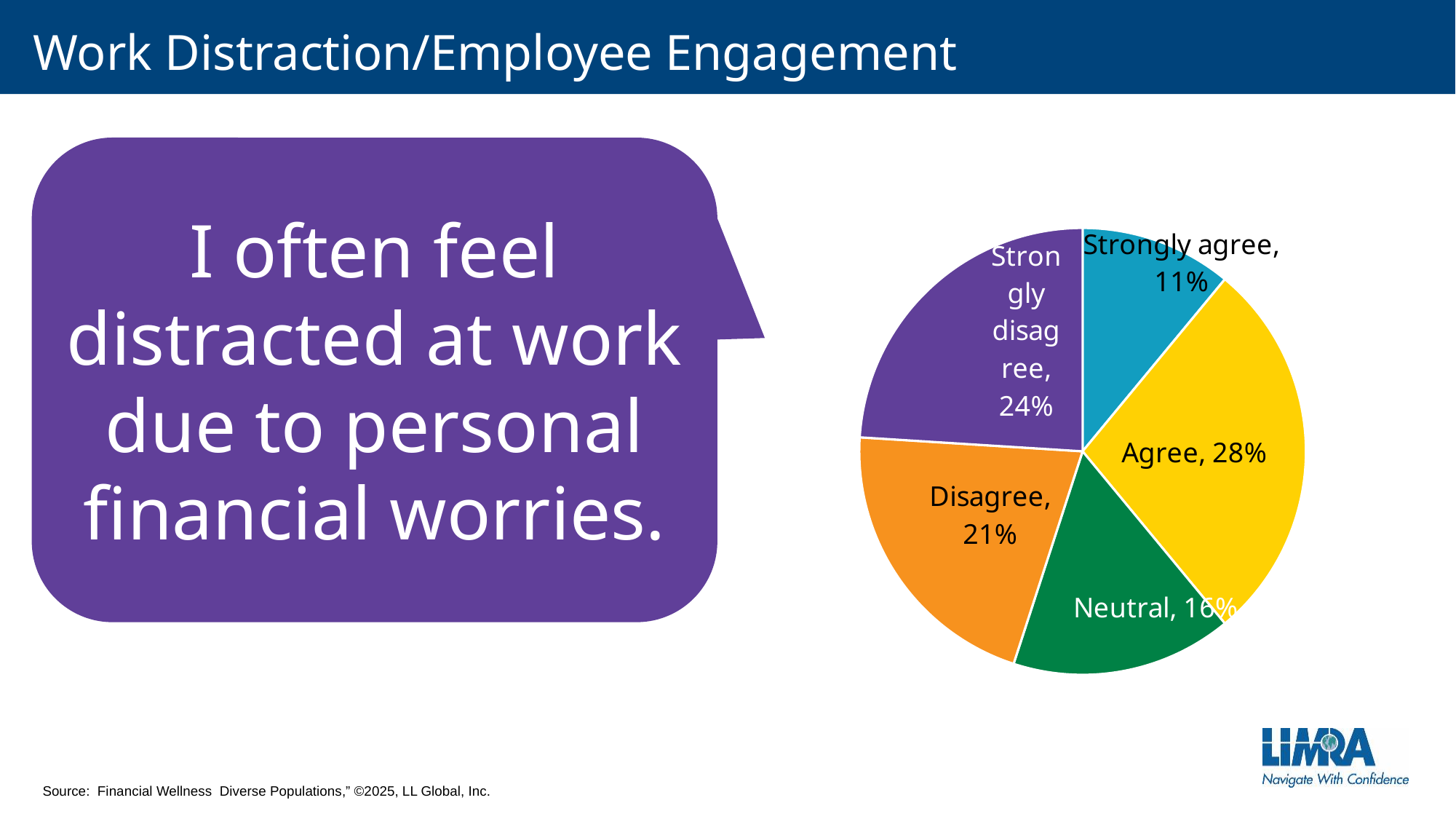
What colour is the "Agree" slice? Yellow Which response has the largest share of the pie? Agree What is the difference in percentage points between "Agree" and "Strongly agree"? 17 What percentage of respondents answered "Neutral"? 16% What percentage of respondents answered "Strongly disagree"? 24% Which response has the smallest share of the pie? Strongly agree What percentage of respondents answered "Strongly agree"? 11% Which is larger, the share for "Disagree" or the share for "Neutral"? Disagree What kind of chart is shown on the slide? Pie chart What percentage of respondents answered "Disagree"? 21% What percentage of respondents answered "Agree"? 28% How many slices does the pie chart have? 5